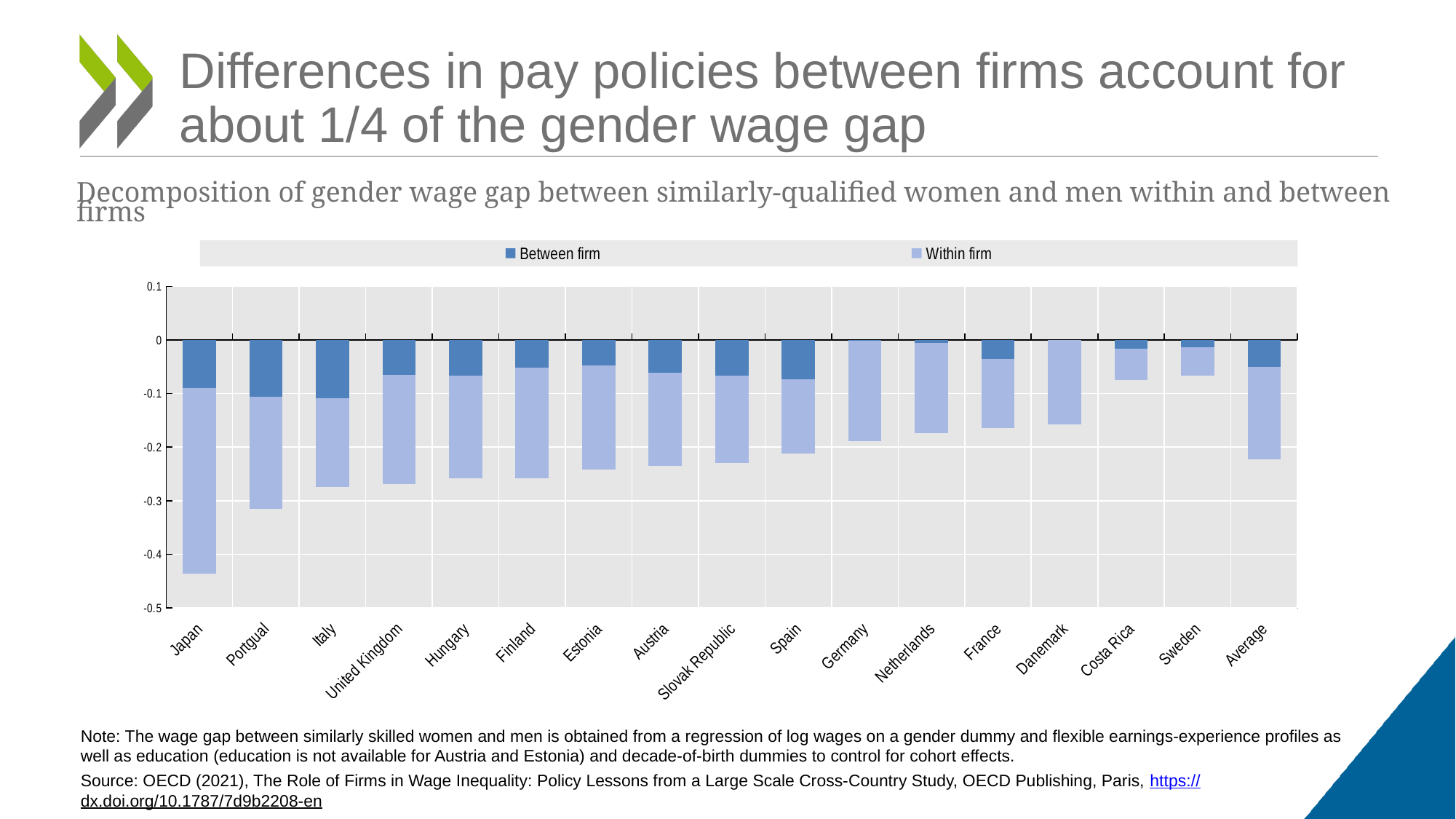
How many series does the legend list? 2 Is the total bar value for Japan greater or less than -0.4? less Which has the longer total bar, Japan or Portugal? Japan Is the total bar value for Germany greater or less than -0.2? greater How many categories are shown on the x axis, including Average? 17 Is the total bar value for Portugal greater or less than -0.3? less What kind of chart is shown on the slide? Stacked bar chart Which country has the largest total gender wage gap (the longest bar)? Japan What are the two series named in the legend? Between firm and Within firm Which has the longer total bar, Netherlands or Sweden? Netherlands Moving from Japan on the left to Sweden on the right, do the total bars generally get longer or shorter? Shorter